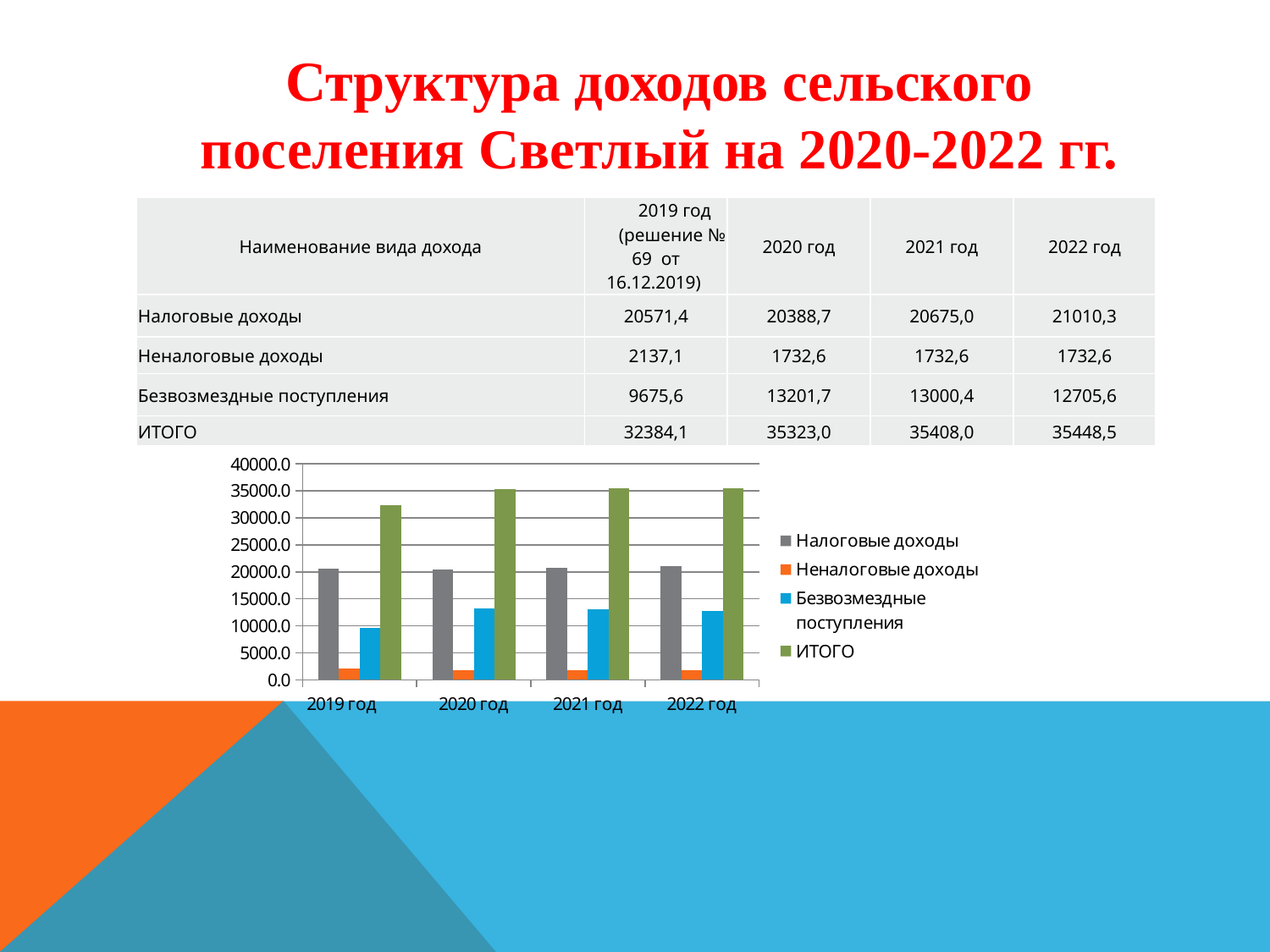
Which year has the lowest ИТОГО value? 2019 год What is the difference between ИТОГО for 2020 год and ИТОГО for 2019 год? 2938,9 How many year categories are shown on the x axis of the chart? 4 What is the value of Налоговые доходы for 2022 год? 21010,3 Do the values for Налоговые доходы rise or fall from 2020 год to 2022 год? rise How many series does the chart legend list? 4 What is the value of Безвозмездные поступления for 2019 год? 9675,6 Which series has the lowest value in 2021 год? Неналоговые доходы What kind of chart is shown on the slide? bar chart Is the value for Неналоговые доходы in 2020 год greater or less than 5000? less Is the value for Налоговые доходы in 2019 год greater or less than 15000? greater Which is larger, Безвозмездные поступления in 2019 год or in 2020 год? 2020 год